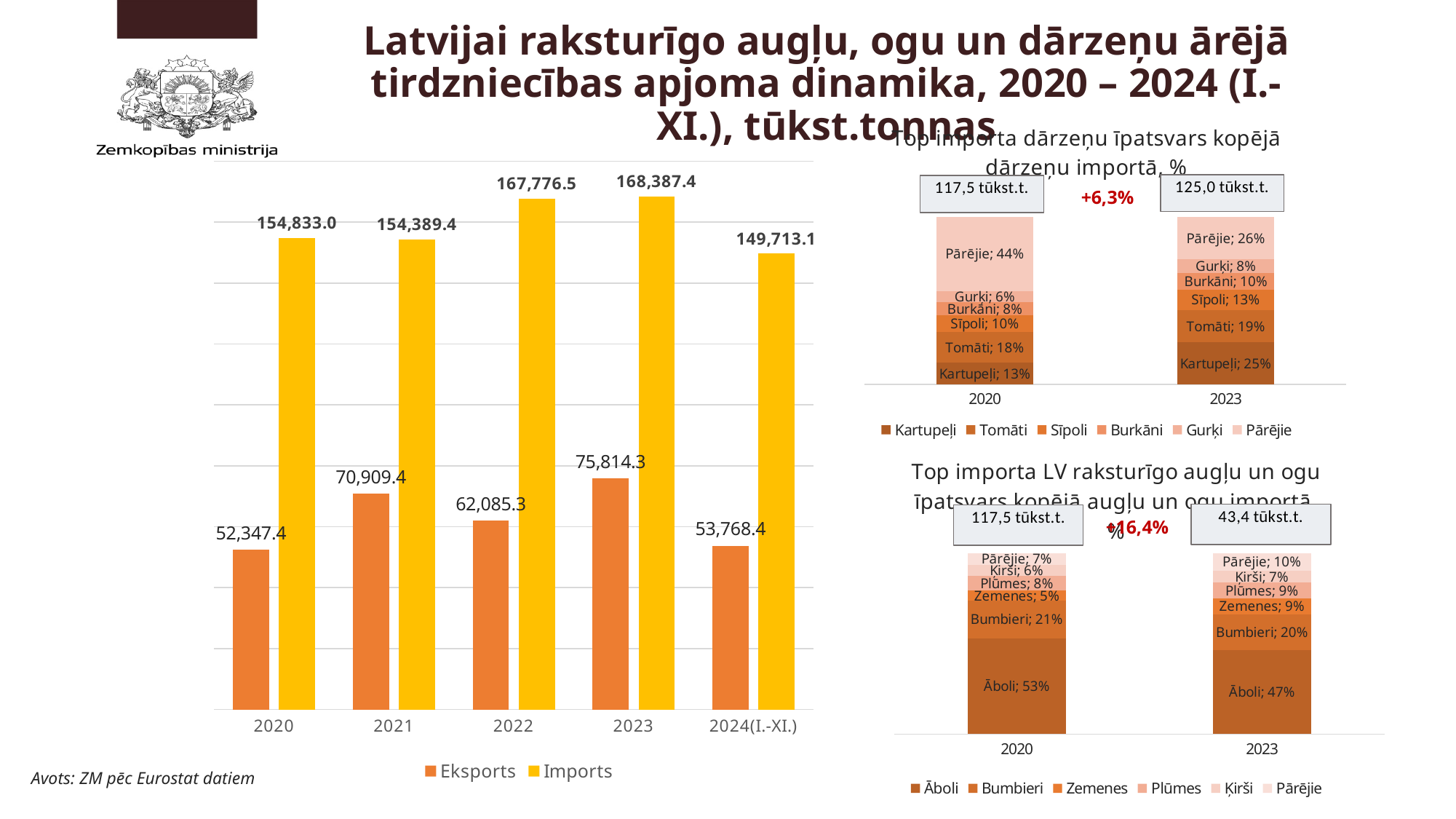
In the large bar chart on the left, what is the Imports value for 2022? 167,776.5 In the large bar chart on the left, which year has the lowest Imports value? 2024(I.-XI.) In the bottom-right chart about augļu un ogu imports, how many categories does the legend list? 6 In the large bar chart on the left, is the Eksports value larger in 2021 or in 2022? 2021 In the chart titled 'Top importa dārzeņu īpatsvars kopējā dārzeņu importā, %', which category has the largest share in 2020? Pārējie In the large bar chart on the left, what is the Eksports value for 2020? 52,347.4 How many series does the legend of the large bar chart on the left list? 2 In the bottom-right chart about augļu un ogu imports, what is the share of Āboli in 2020? 53% What type of chart is the large chart on the left? Bar chart In the large bar chart on the left, which year has the highest Eksports value? 2023 In the large bar chart on the left, what is the difference between Imports and Eksports in 2023? 92,573.1 In the chart titled 'Top importa dārzeņu īpatsvars kopējā dārzeņu importā, %', what is the share of Kartupeļi in 2023? 25%